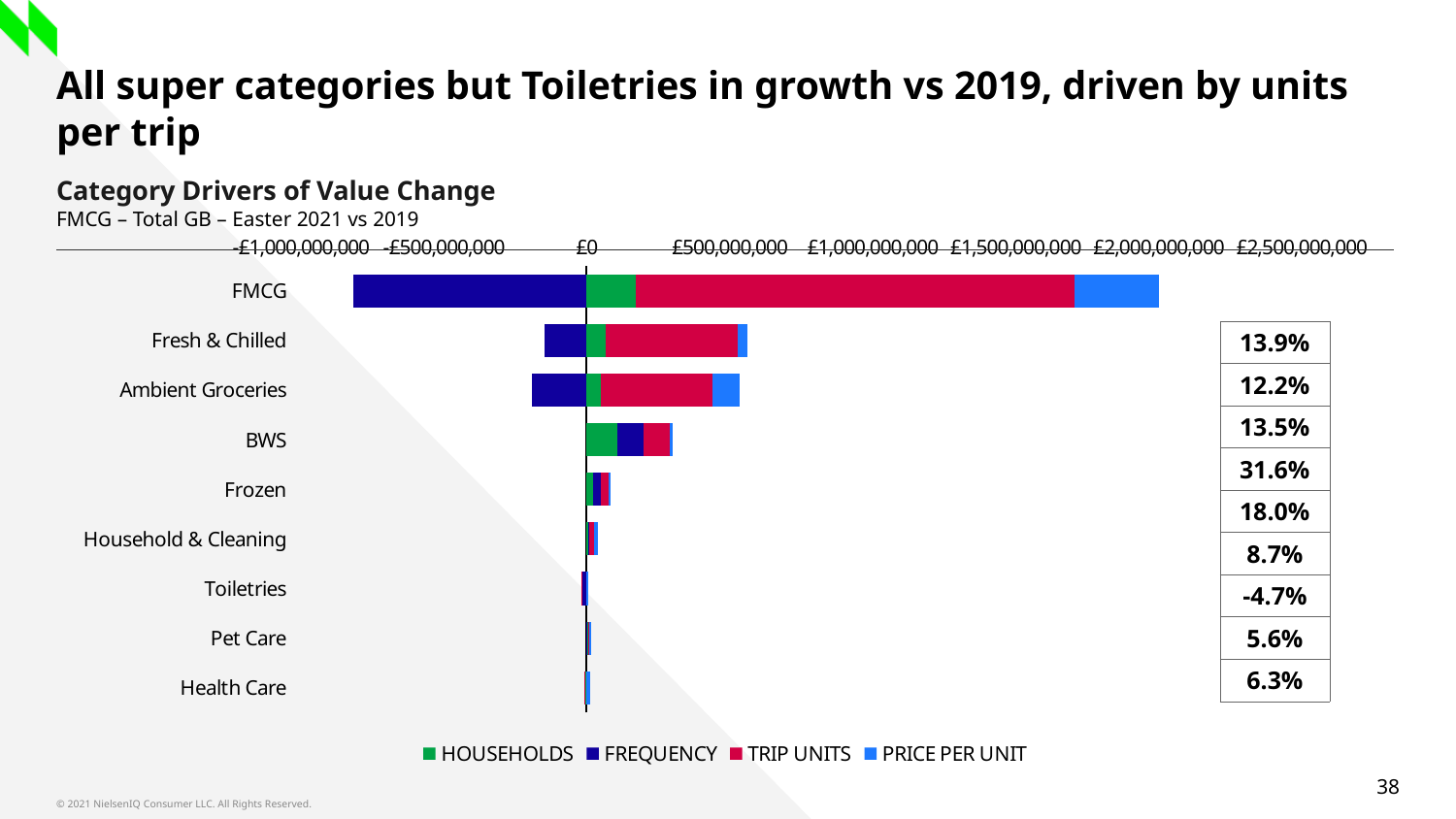
Is the positive value for Frozen greater or less than £500,000,000? less How many series does the legend list? 4 Is the positive value for FMCG greater or less than £1,500,000,000? greater What kind of chart is shown on the slide? Stacked bar chart Which category has the longest bar on the chart? FMCG Which series has a negative contribution for FMCG? FREQUENCY Which series contributes the largest positive segment for FMCG? TRIP UNITS What is the title of the chart? Category Drivers of Value Change Which series are listed in the legend? HOUSEHOLDS, FREQUENCY, TRIP UNITS, PRICE PER UNIT Is the positive value for BWS greater or less than £500,000,000? less How many categories are plotted on the chart? 9 Which has the larger positive bar, Fresh & Chilled or BWS? Fresh & Chilled